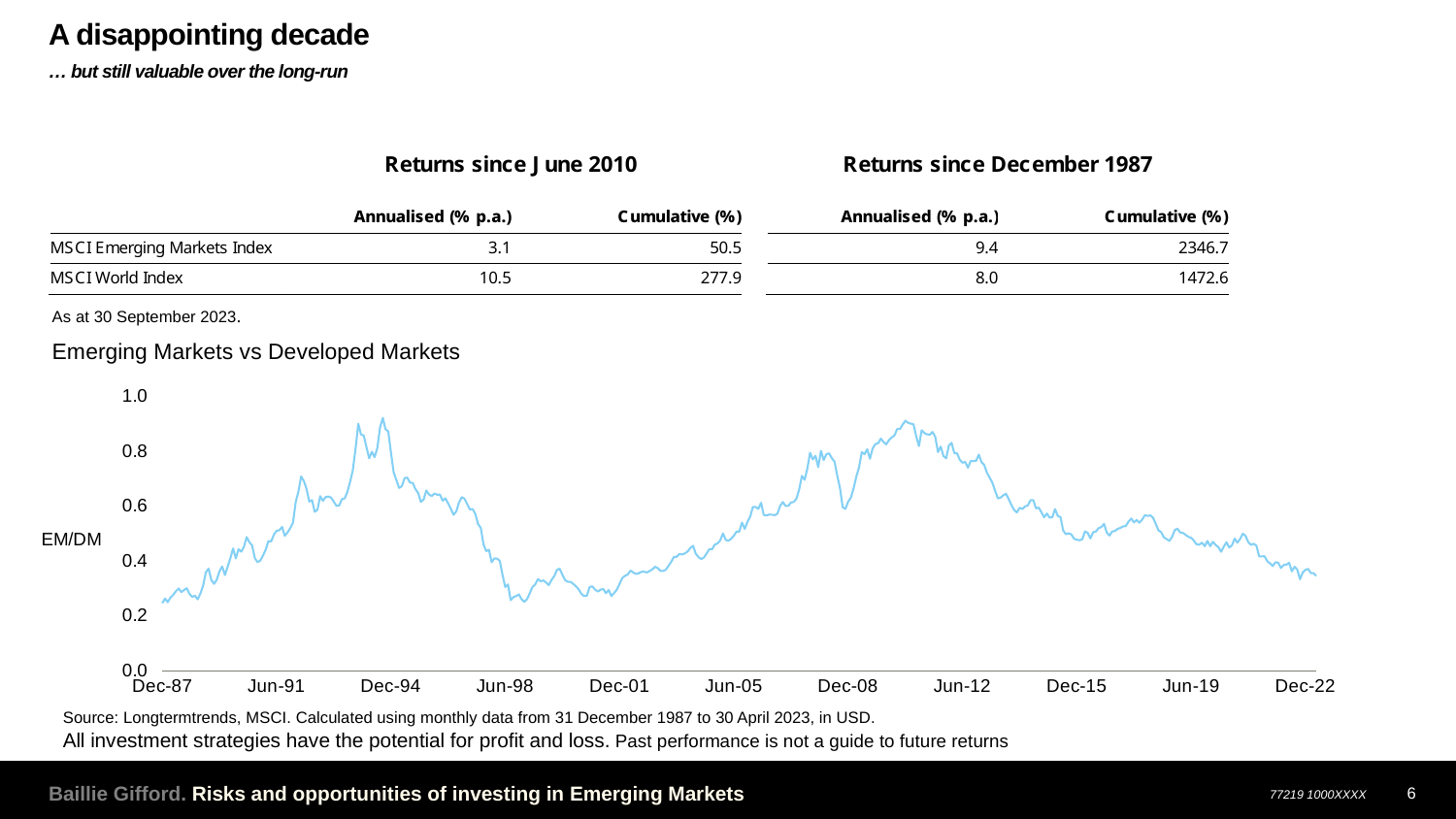
Is the EM/DM value at Dec-22 greater or less than 0.6? less Does the EM/DM line generally rise or fall between Dec-87 and Dec-94? rise Is the EM/DM value at Jun-12 greater or less than 0.6? greater Which is larger on the chart, the EM/DM value at Jun-12 or at Dec-22? Jun-12 Is the EM/DM value at Dec-15 greater or less than 0.8? less What is the title of the chart on the slide? Emerging Markets vs Developed Markets What label is shown on the vertical axis of the chart? EM/DM How many date labels are shown along the x axis of the chart? 11 Does the EM/DM line generally rise or fall between Jun-12 and Dec-22? fall How many lines are plotted on the Emerging Markets vs Developed Markets chart? 1 What kind of chart is shown under the heading 'Emerging Markets vs Developed Markets'? line chart